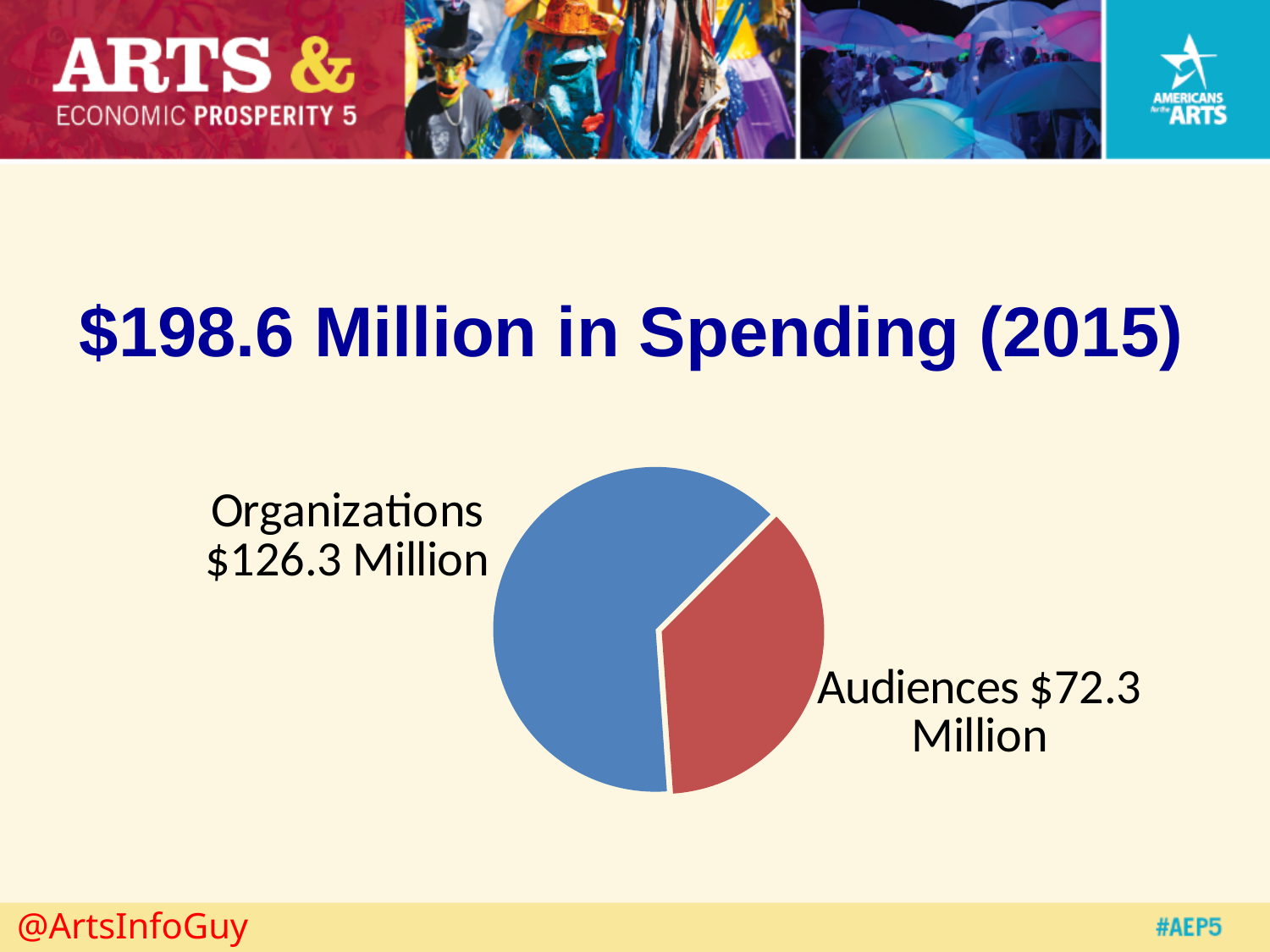
What colour is the Organizations slice of the pie chart? blue What year does the spending total in the title refer to? 2015 What type of chart is shown on the slide? pie chart What is the spending value for Audiences? $72.3 Million What is the total spending shown in the slide title? $198.6 Million What share of the total spending comes from Organizations? 63.6% Which category has the smaller share of spending? Audiences Which category has the larger share of spending? Organizations How much more did Organizations spend than Audiences? $54.0 Million Is spending by Organizations larger or smaller than spending by Audiences? larger How many slices does the pie chart have? 2 What is the spending value for Organizations? $126.3 Million